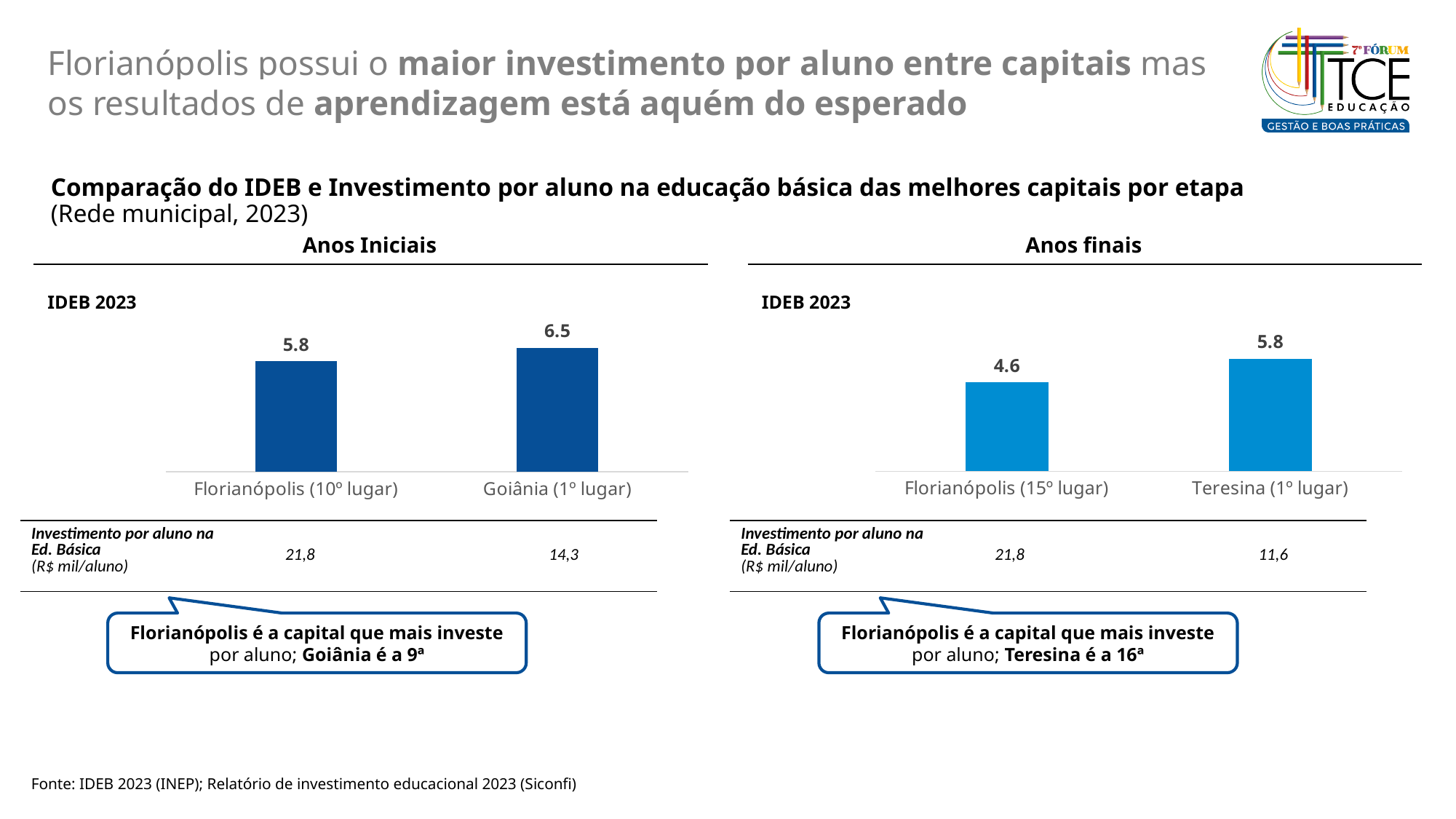
In the Anos finais chart, which category has the lowest IDEB 2023 value? Florianópolis (15º lugar) What type of chart is used for the Anos finais IDEB 2023 data? Bar chart In the Anos finais chart, what is the IDEB 2023 value for Florianópolis (15º lugar)? 4.6 In the Anos finais chart, what is the difference between the IDEB 2023 values of Teresina and Florianópolis? 1.2 In the Anos Iniciais chart, which category has the highest IDEB 2023 value? Goiânia (1º lugar) In the Anos Iniciais chart, what is the difference between the IDEB 2023 values of Goiânia and Florianópolis? 0.7 In the Anos Iniciais chart, what is the IDEB 2023 value for Florianópolis (10º lugar)? 5.8 How many bars are plotted in the Anos Iniciais chart? 2 What is the title of the chart on the left side of the slide? Anos Iniciais In the Anos finais chart, which is larger: the IDEB 2023 value for Teresina or for Florianópolis? Teresina In the Anos finais chart, what is the IDEB 2023 value for Teresina (1º lugar)? 5.8 In the Anos Iniciais chart, what is the IDEB 2023 value for Goiânia (1º lugar)? 6.5